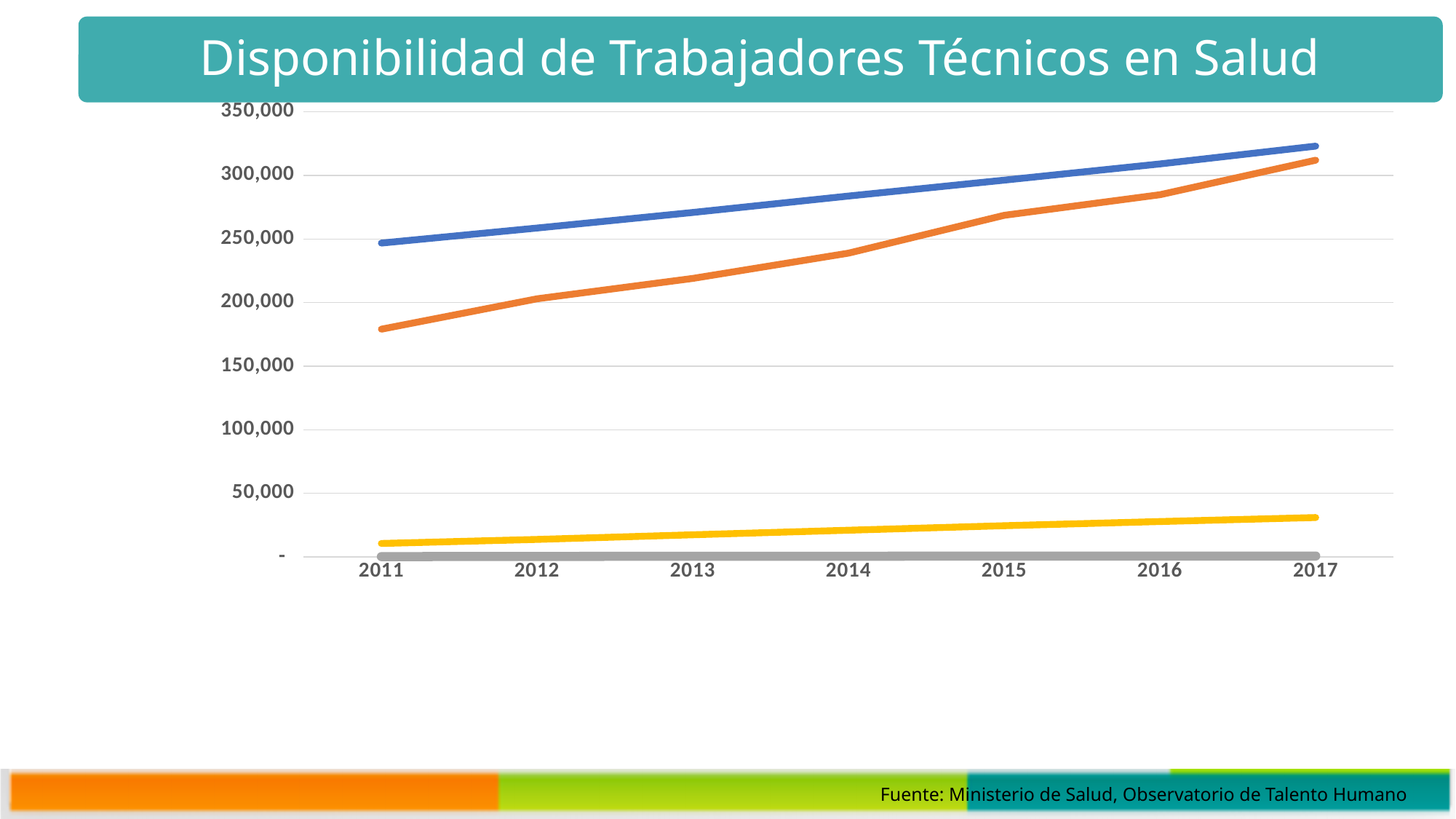
Is the value of the blue line in 2017 greater or less than 300,000? greater Does the orange line rise or fall from 2011 to 2017? rises What kind of chart is shown on the slide? line chart In 2011, which line has the larger value, the blue line or the orange line? blue line What is the title of the chart? Disponibilidad de Trabajadores Técnicos en Salud How many years are shown on the x axis? 7 Is the value of the yellow line in 2017 greater or less than 50,000? less Which line has the lowest values across all years? gray line How many lines are plotted on the chart? 4 Does the blue line rise or fall from 2011 to 2017? rises Is the value of the blue line in 2011 greater or less than 200,000? greater